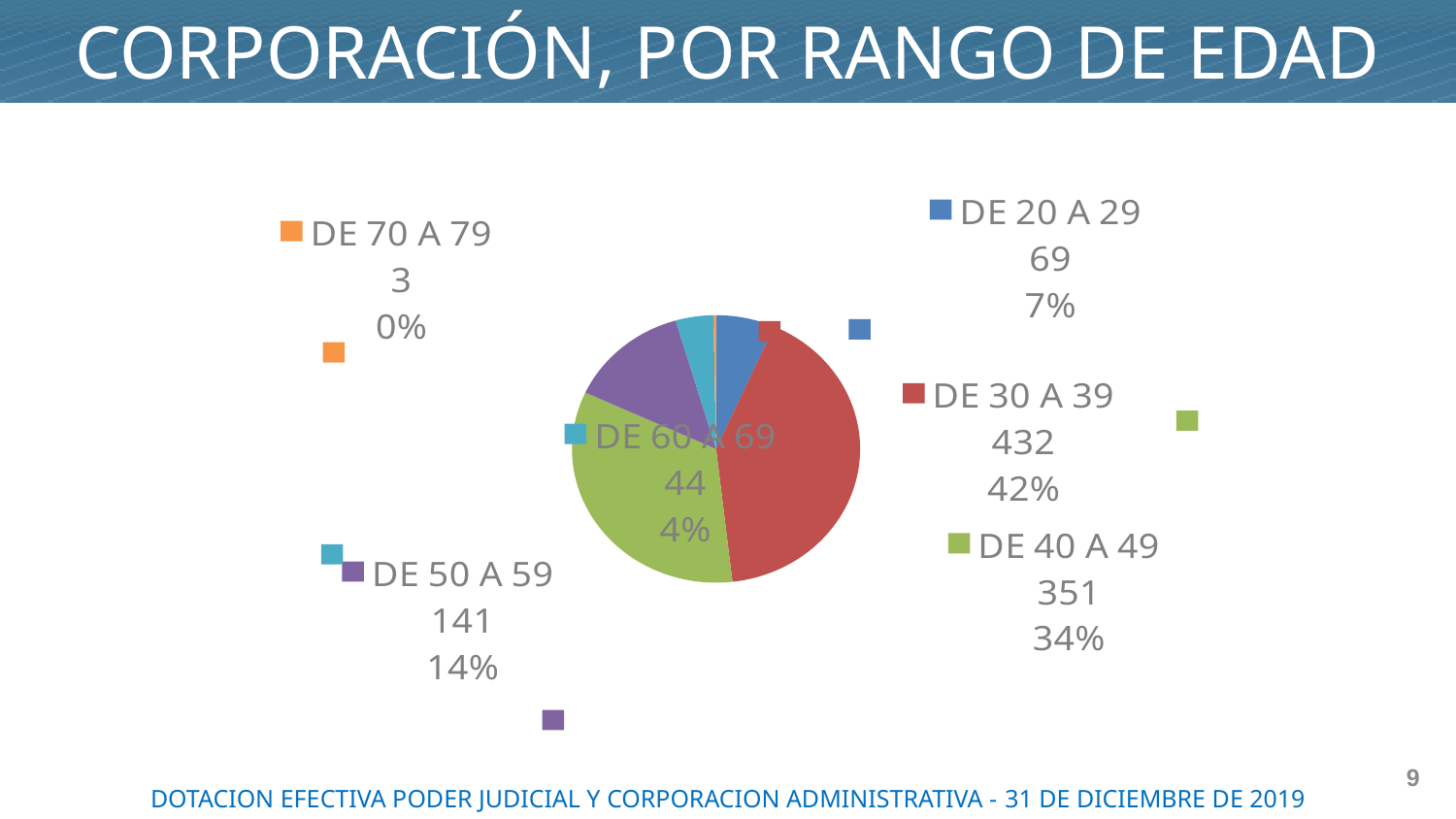
What is the value for DE 50 A 59? 141 What is the value for DE 30 A 39? 432 What share of the pie does DE 20 A 29 represent? 7% What kind of chart is shown on the slide? Pie chart What is the value for DE 40 A 49? 351 What share of the pie does DE 60 A 69 represent? 4% Which age range has the highest value? DE 30 A 39 What is the value for DE 70 A 79? 3 Which age range has the lowest value? DE 70 A 79 How many age-range categories does the pie chart show? 6 What is the difference between the values for DE 30 A 39 and DE 40 A 49? 81 Which is larger, the value for DE 50 A 59 or the value for DE 20 A 29? DE 50 A 59